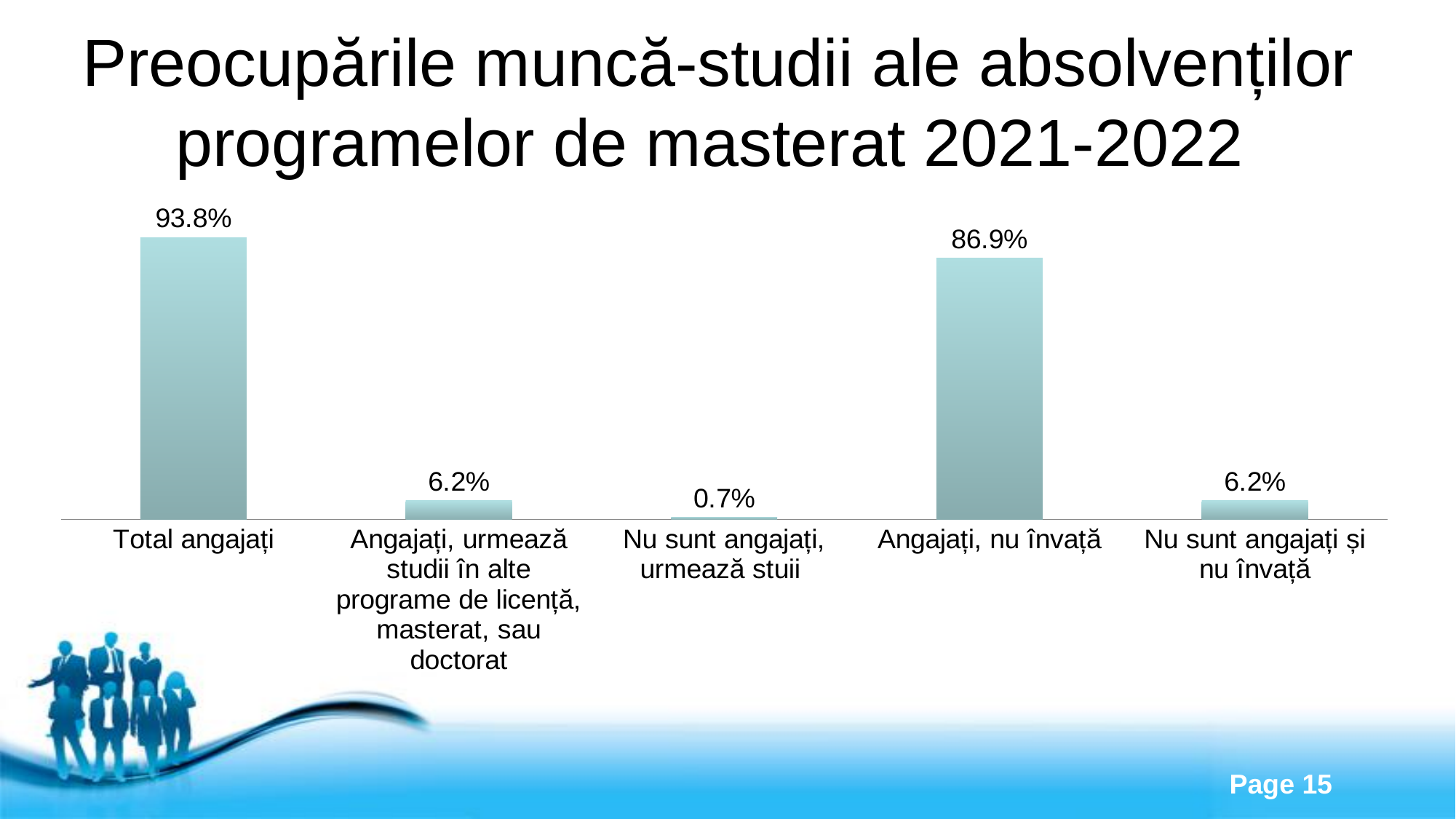
Which is larger: 'Angajați, nu învață' or 'Nu sunt angajați și nu învață'? Angajați, nu învață What is the difference between 'Total angajați' and 'Angajați, nu învață'? 6.9% How many categories are shown in the chart? 5 Which category has the highest value? Total angajați What is the difference between 'Angajați, urmează studii în alte programe de licență, masterat, sau doctorat' and 'Nu sunt angajați, urmează stuii'? 5.5% What kind of chart is shown on the slide? Bar chart What is the title of the slide containing the chart? Preocupările muncă-studii ale absolvenților programelor de masterat 2021-2022 What is the value for 'Nu sunt angajați și nu învață'? 6.2% What is the value for 'Total angajați'? 93.8% What is the value for 'Nu sunt angajați, urmează stuii'? 0.7% Which category has the lowest value? Nu sunt angajați, urmează stuii What is the value for 'Angajați, nu învață'? 86.9%